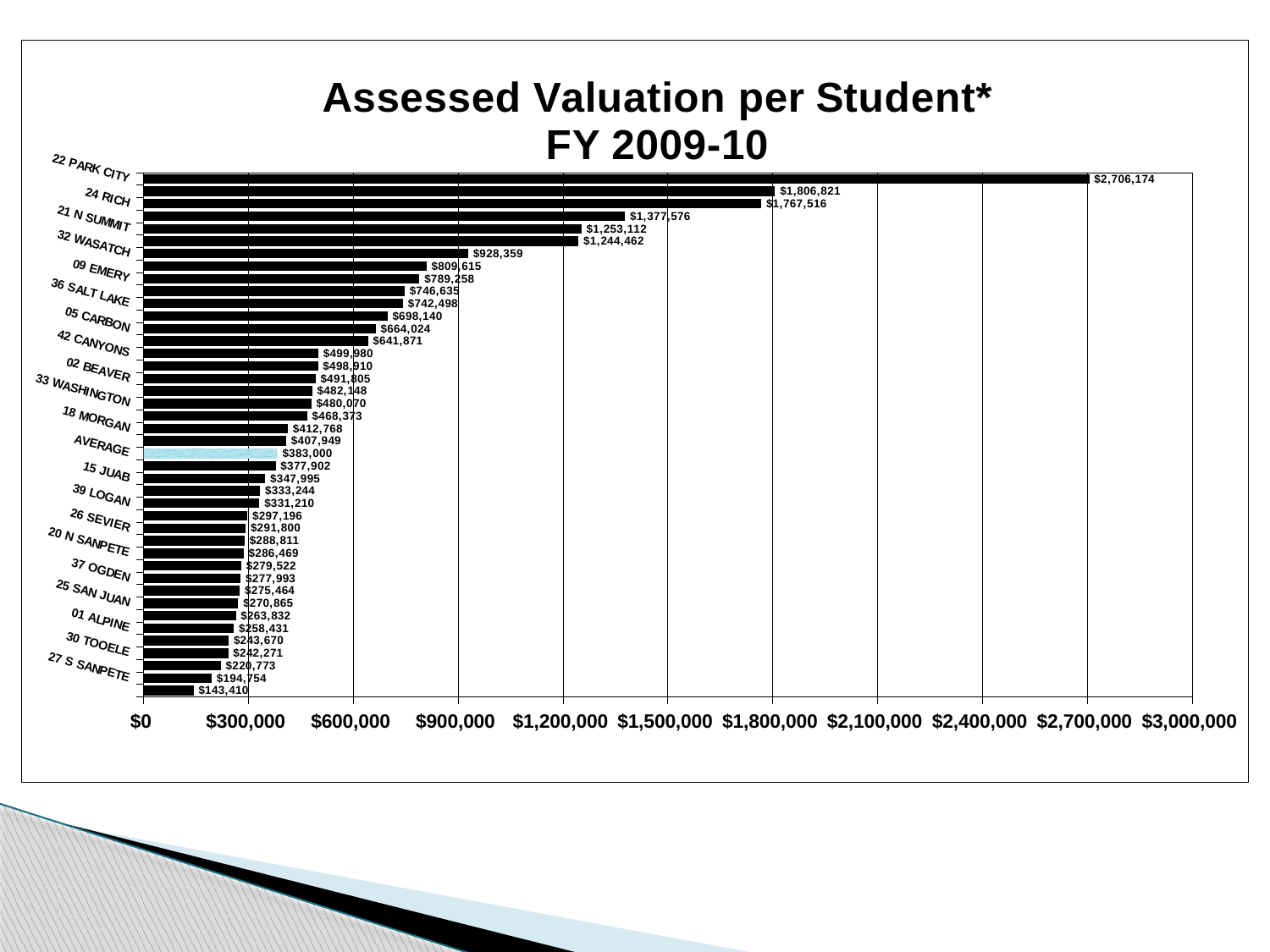
What is the assessed valuation per student for 22 PARK CITY? $2,706,174 Is the AVERAGE value greater or less than $600,000? less What colour is the AVERAGE bar, which differs from the other bars? light blue What kind of chart is shown on the slide? bar chart Which district has the highest assessed valuation per student? 22 PARK CITY Do the bar values increase or decrease going from the top of the chart to the bottom? decrease What is the difference between the value for 22 PARK CITY and the AVERAGE? $2,323,174 What is the lowest value labeled on the chart? $143,410 Which is larger, the value for 22 PARK CITY or the value for 24 RICH? 22 PARK CITY Is the value for 22 PARK CITY greater or less than $2,400,000? greater What is the value shown for the AVERAGE bar? $383,000 What is the title of the chart? Assessed Valuation per Student* FY 2009-10